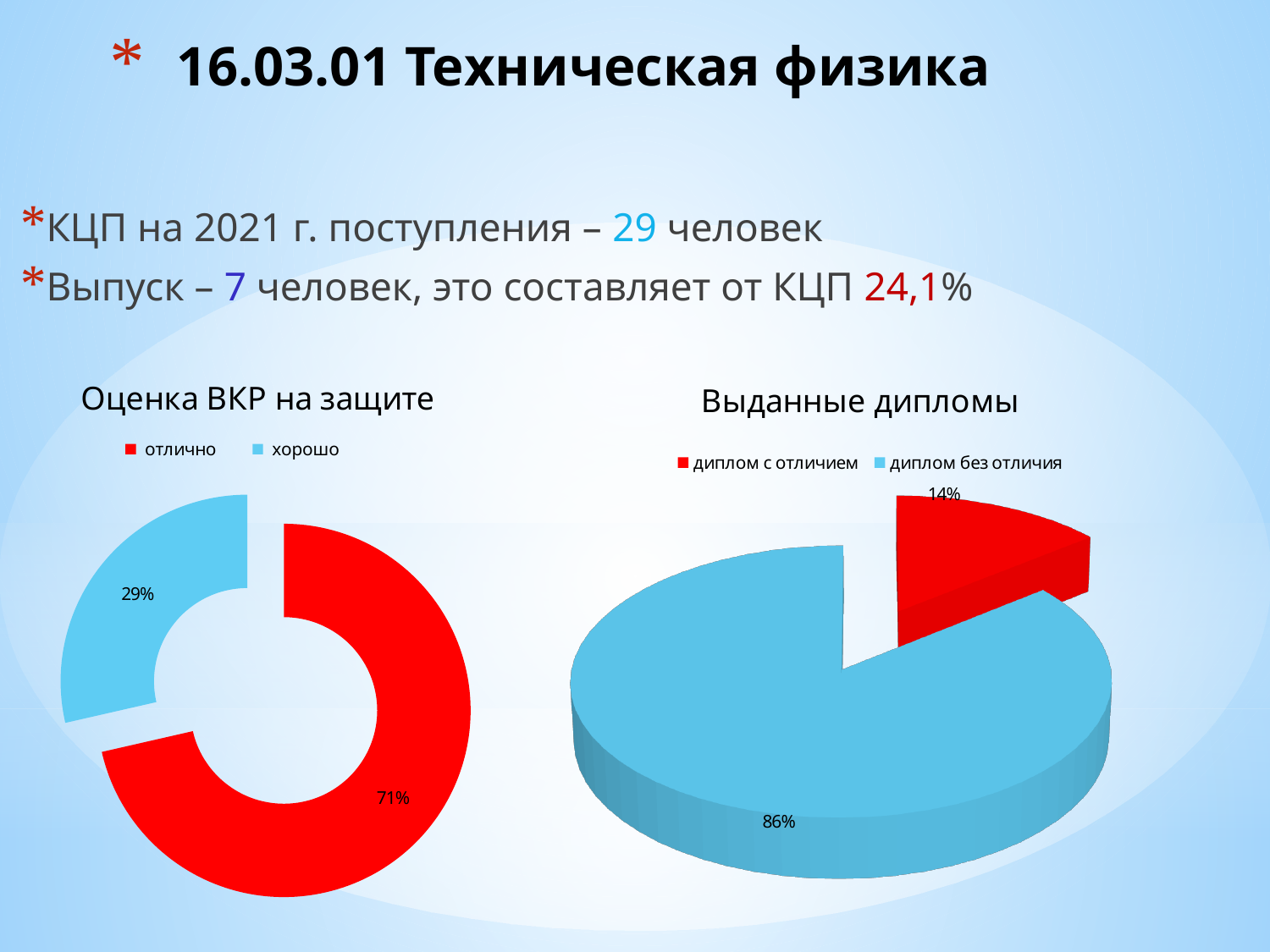
In the chart titled "Выданные дипломы", what is the difference in percentage points between "диплом без отличия" and "диплом с отличием"? 72 In the chart titled "Оценка ВКР на защите", what colour represents "хорошо"? light blue What kind of chart is the chart titled "Выданные дипломы"? pie chart In the chart titled "Выданные дипломы", which category has the smallest share? диплом с отличием In the chart titled "Оценка ВКР на защите", which category has the largest share? отлично In the chart titled "Оценка ВКР на защите", what is the difference in percentage points between "отлично" and "хорошо"? 42 In the chart titled "Оценка ВКР на защите", how many categories does the legend list? 2 In the chart titled "Выданные дипломы", what share is labelled for "диплом с отличием"? 14% In the chart titled "Оценка ВКР на защите", what share is labelled for "хорошо"? 29% In the chart titled "Оценка ВКР на защите", what share is labelled for "отлично"? 71% In the chart titled "Выданные дипломы", which is larger: "диплом с отличием" or "диплом без отличия"? диплом без отличия In the chart titled "Выданные дипломы", what share is labelled for "диплом без отличия"? 86%